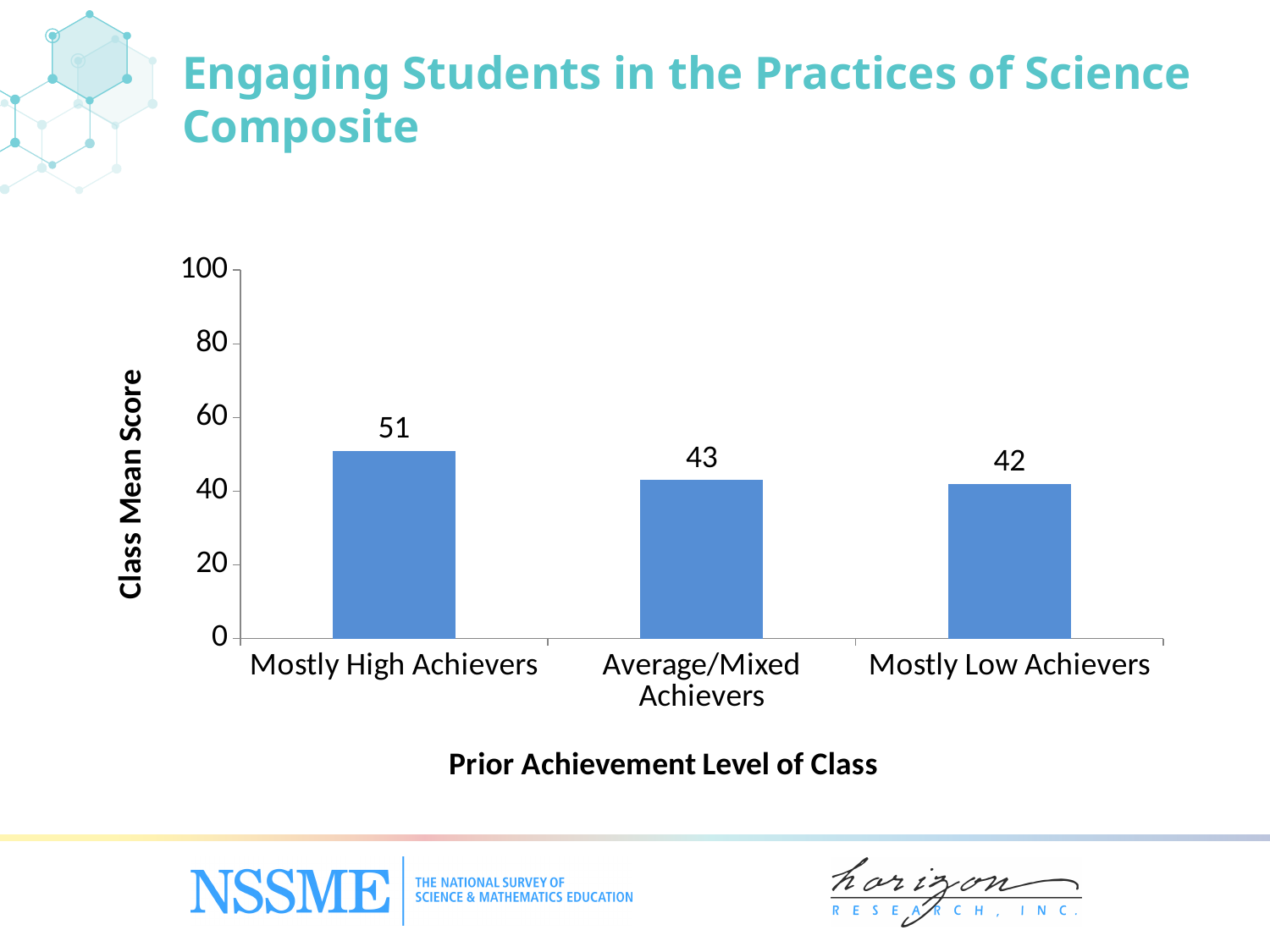
How many prior achievement level categories are shown in the chart? 3 What kind of chart is shown on the slide? Bar chart Is the value for Mostly High Achievers greater or less than 40? greater What is the difference in class mean score between Mostly High Achievers and Mostly Low Achievers? 9 What is the label of the vertical axis? Class Mean Score What is the class mean score for Mostly High Achievers? 51 What is the class mean score for Mostly Low Achievers? 42 What is the difference in class mean score between Mostly High Achievers and Average/Mixed Achievers? 8 Which prior achievement level has the highest class mean score? Mostly High Achievers Which has a larger class mean score, Mostly High Achievers or Average/Mixed Achievers? Mostly High Achievers What is the class mean score for Average/Mixed Achievers? 43 Is the value for Mostly Low Achievers greater or less than 60? less